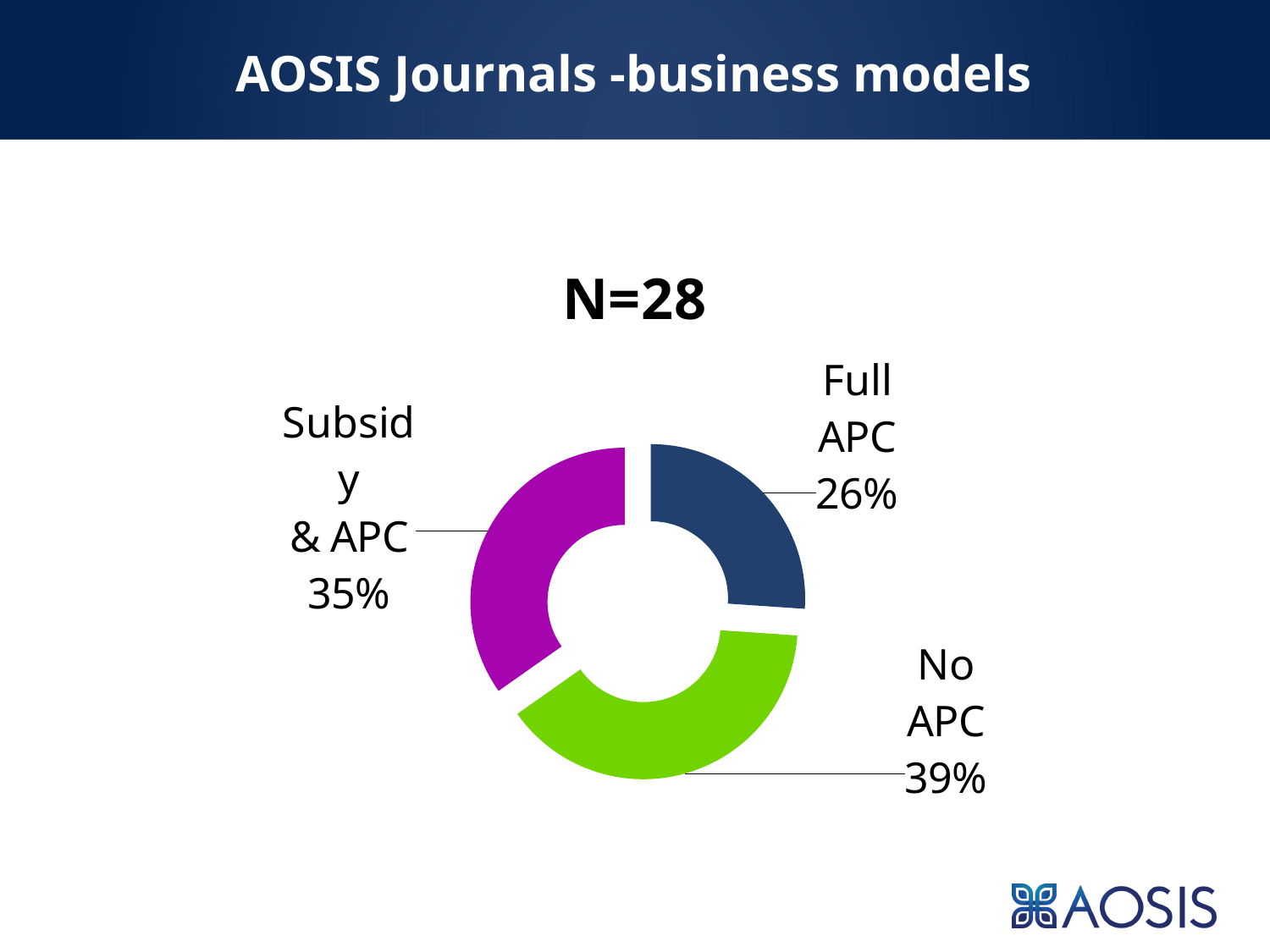
Which category has the smallest share of the chart? Full APC What share of the chart does No APC account for? 39% What share of the chart does Subsidy & APC account for? 35% What is the title of the chart? N=28 What is the difference in percentage points between Subsidy & APC and Full APC? 9 What colour is the No APC segment of the chart? Green How many categories are shown in the chart? 3 What is the difference in percentage points between No APC and Full APC? 13 Which category has the largest share of the chart? No APC What share of the chart does Full APC account for? 26% What kind of chart is shown on the slide? Doughnut chart Which is larger, the share for Subsidy & APC or the share for Full APC? Subsidy & APC